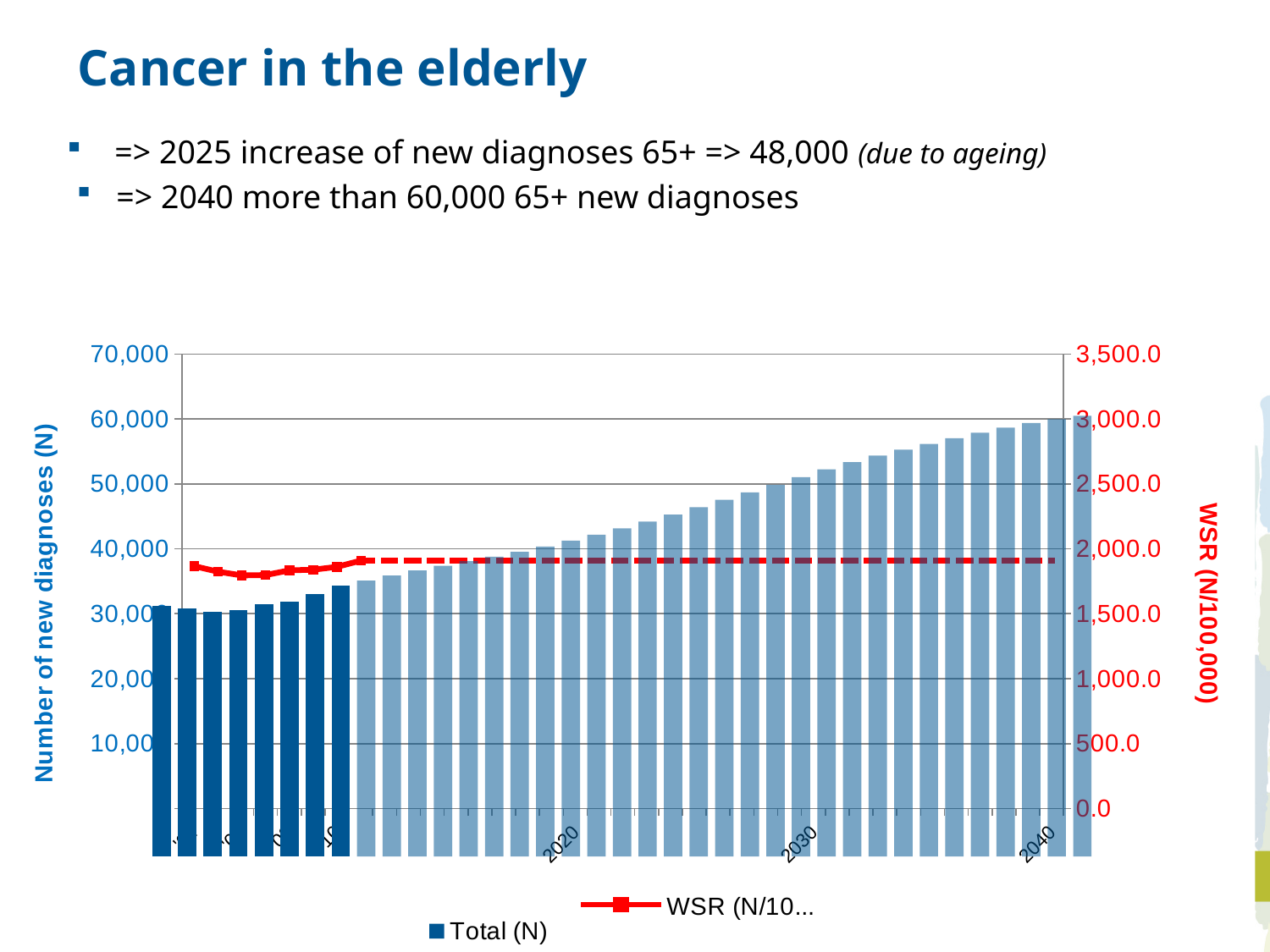
Which series is plotted as bars? Total (N) Do the Total (N) bars rise or fall from left to right along the x axis? Rise What is the title of the right vertical axis? WSR (N/100,000) Is the Total (N) value for 2020 greater or less than 50,000? less What kind of chart is shown on the slide? A bar chart combined with a line chart Is the Total (N) value for 2040 greater or less than 50,000? greater What is the title of the left vertical axis? Number of new diagnoses (N) Is the WSR value for 2030 greater or less than 2,500.0? less Which year has a larger Total (N) value, 2020 or 2040? 2040 How many series does the legend list? 2